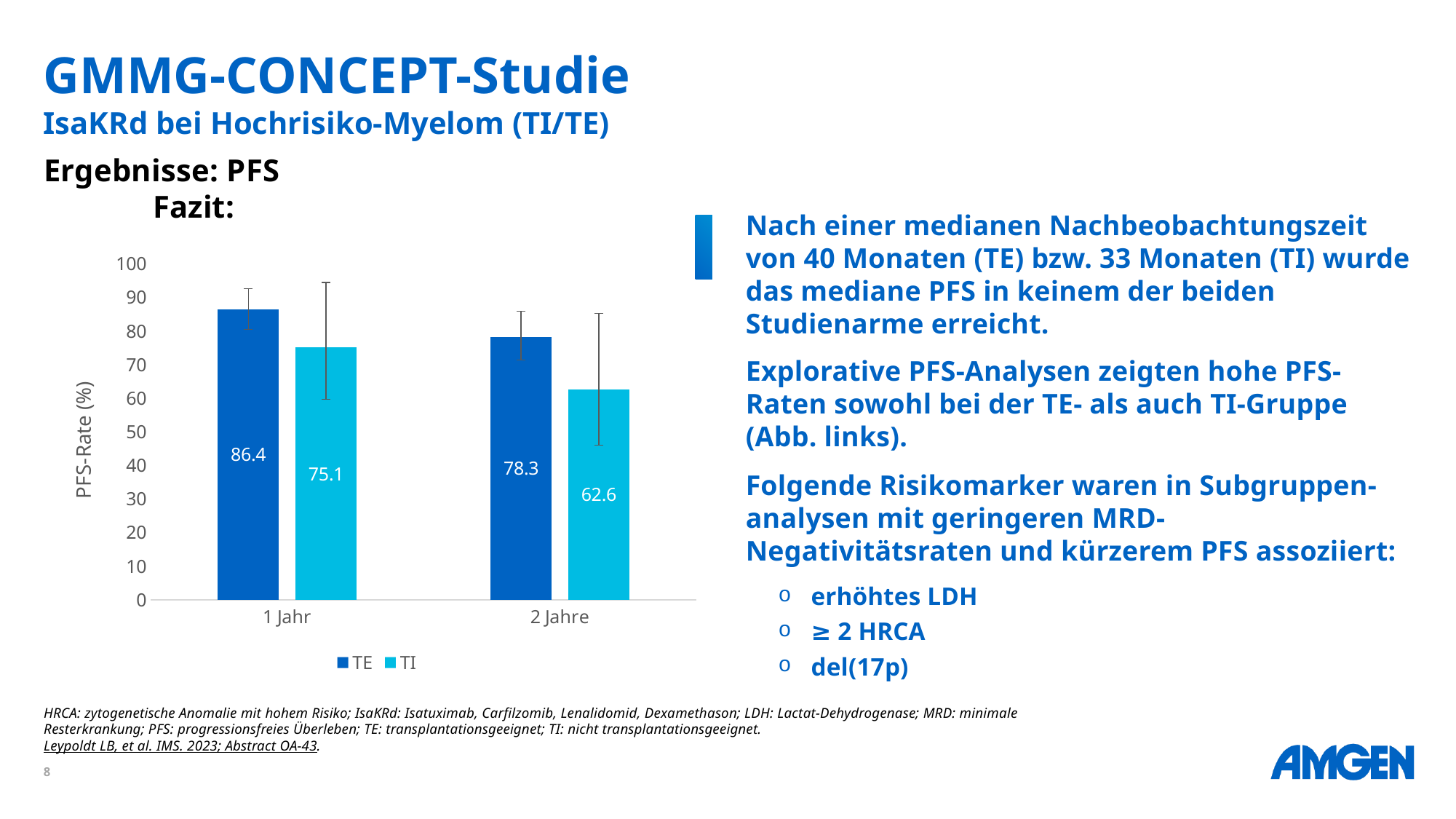
Which group and time point has the lowest PFS rate? TI at 2 Jahre How many categories are shown on the x axis? 2 How many series does the legend list? 2 What is the difference between the TE and TI PFS rates at 1 Jahr? 11.3 Which is larger, the TE PFS rate at 2 Jahre or the TI PFS rate at 1 Jahr? TE at 2 Jahre Which group and time point has the highest PFS rate? TE at 1 Jahr What kind of chart is shown on the slide? Bar chart What is the PFS rate for the TI group at 1 Jahr? 75.1 What is the difference between the TE PFS rate at 1 Jahr and at 2 Jahre? 8.1 What is the PFS rate for the TE group at 1 Jahr? 86.4 What is the label of the y axis? PFS-Rate (%) What is the PFS rate for the TI group at 2 Jahre? 62.6